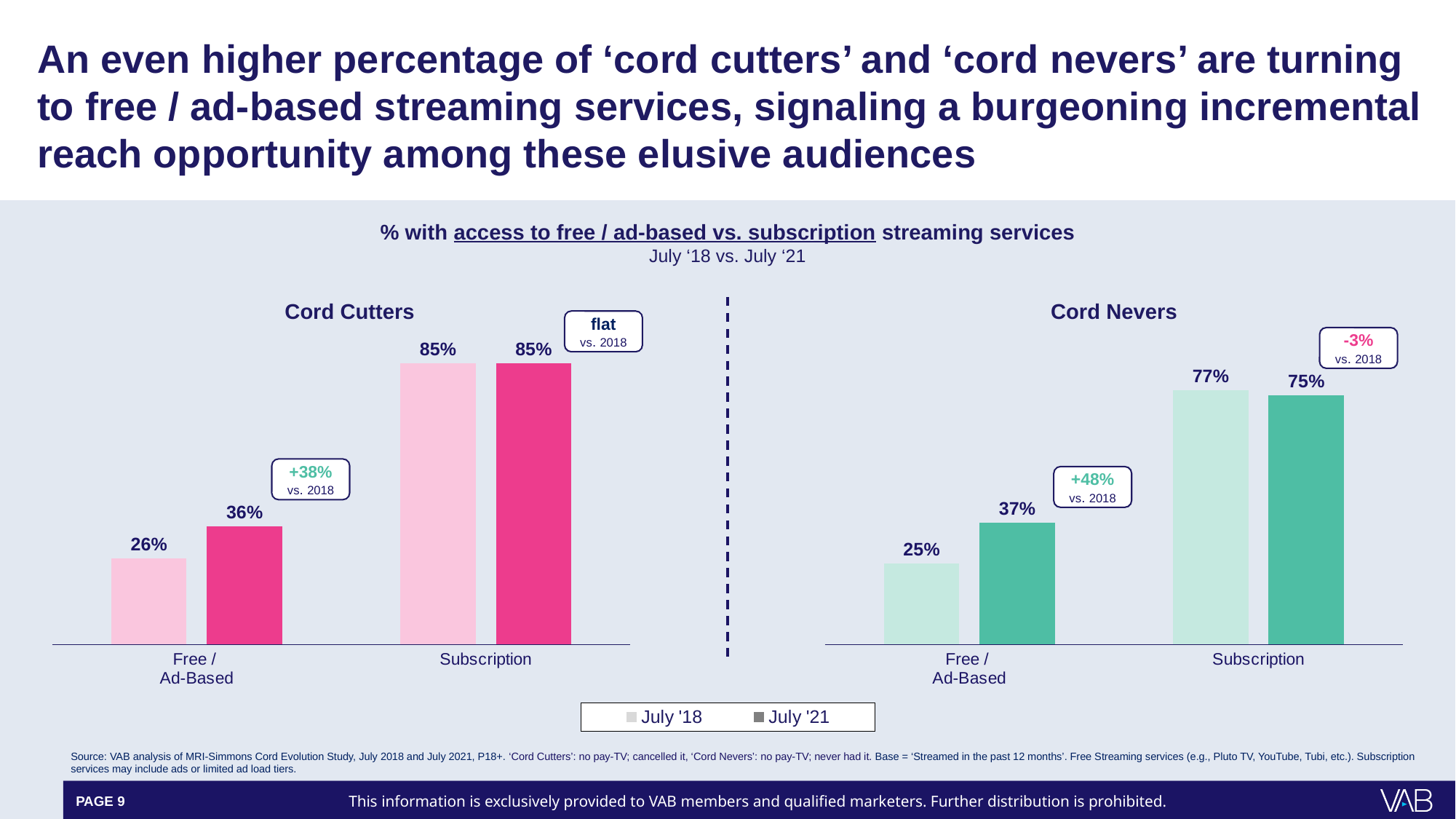
In the Cord Nevers chart, which bar has the highest value? Subscription (July '18) In the Cord Nevers chart, which is larger: the July '21 value for Free / Ad-Based or the July '21 value for Subscription? Subscription In the Cord Cutters chart, what is the July '18 value for Subscription? 85% How many series does the legend list? 2 In the Cord Cutters chart, what is the difference between the July '21 and July '18 values for Free / Ad-Based? 10 percentage points What kind of chart is used for Cord Cutters? Bar chart In the Cord Cutters chart, what is the July '21 value for Free / Ad-Based? 36% In the Cord Nevers chart, what percentage change vs. 2018 is shown in the callout for Free / Ad-Based? +48% In the Cord Cutters chart, which category has the lowest value? Free / Ad-Based (July '18) In the Cord Nevers chart, what is the July '21 value for Subscription? 75% In the Cord Nevers chart, what is the July '18 value for Free / Ad-Based? 25% In the Cord Nevers chart, what is the difference between the July '18 and July '21 values for Subscription? 2 percentage points